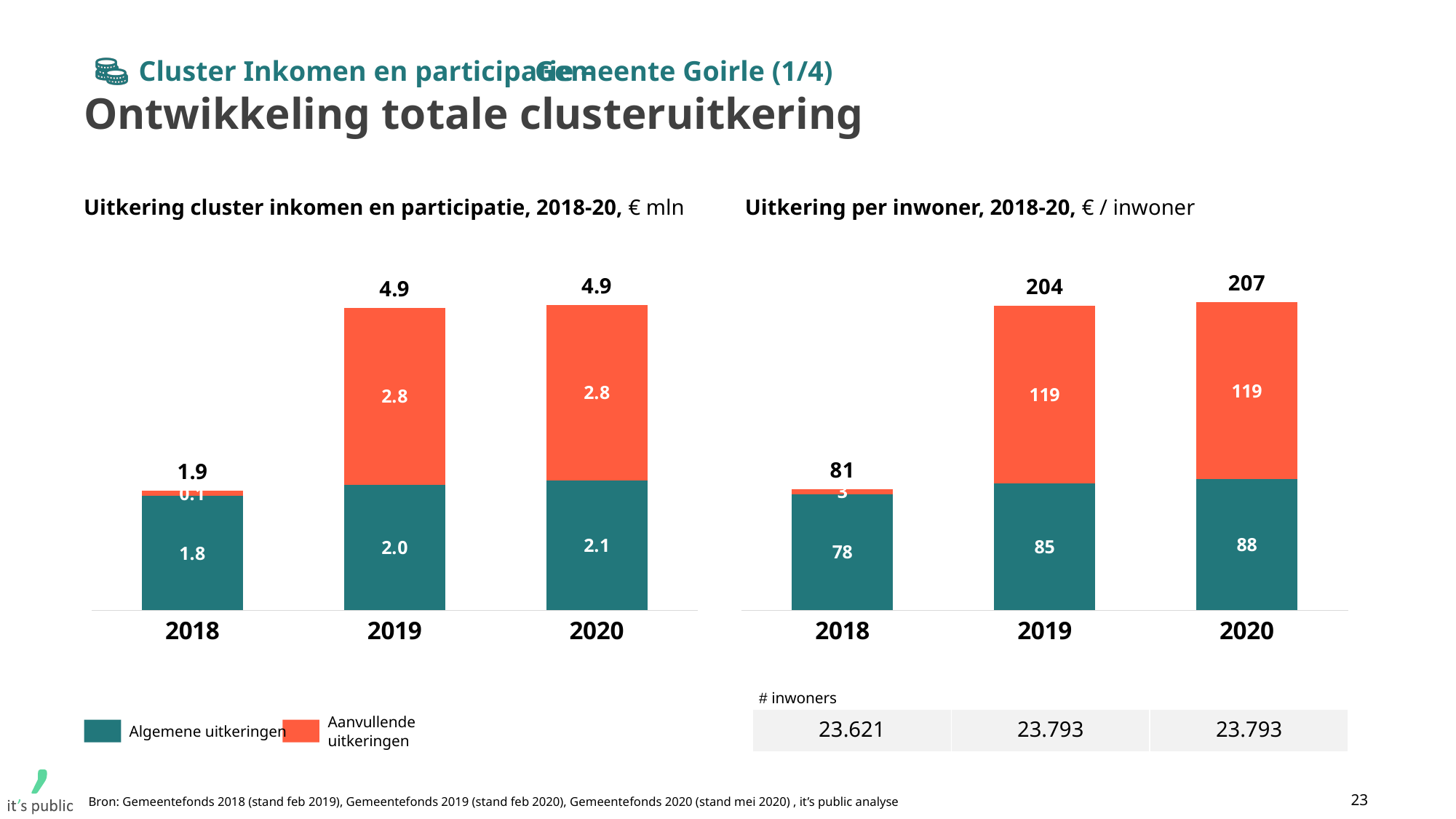
In the right chart (Uitkering per inwoner), what is the value of Aanvullende uitkeringen in 2018? 3 In the right chart (Uitkering per inwoner), what is the value of Algemene uitkeringen in 2020? 88 In the left chart (Uitkering cluster inkomen en participatie), is the Aanvullende uitkeringen value larger in 2018 or in 2019? 2019 In the right chart (Uitkering per inwoner), what is the difference between the Algemene uitkeringen values for 2020 and 2018? 10 In the left chart (Uitkering cluster inkomen en participatie), what is the value of Aanvullende uitkeringen in 2020? 2.8 What type of chart is the right chart (Uitkering per inwoner)? Stacked bar chart In the right chart (Uitkering per inwoner), what is the total of the stacked bar for 2019? 204 How many series does the legend list? 2 In the left chart (Uitkering cluster inkomen en participatie), which year has the lowest total? 2018 In the left chart (Uitkering cluster inkomen en participatie), what is the value of Algemene uitkeringen in 2019? 2.0 In the right chart (Uitkering per inwoner), which year has the highest total? 2020 In the left chart (Uitkering cluster inkomen en participatie), what is the total of the stacked bar for 2018? 1.9